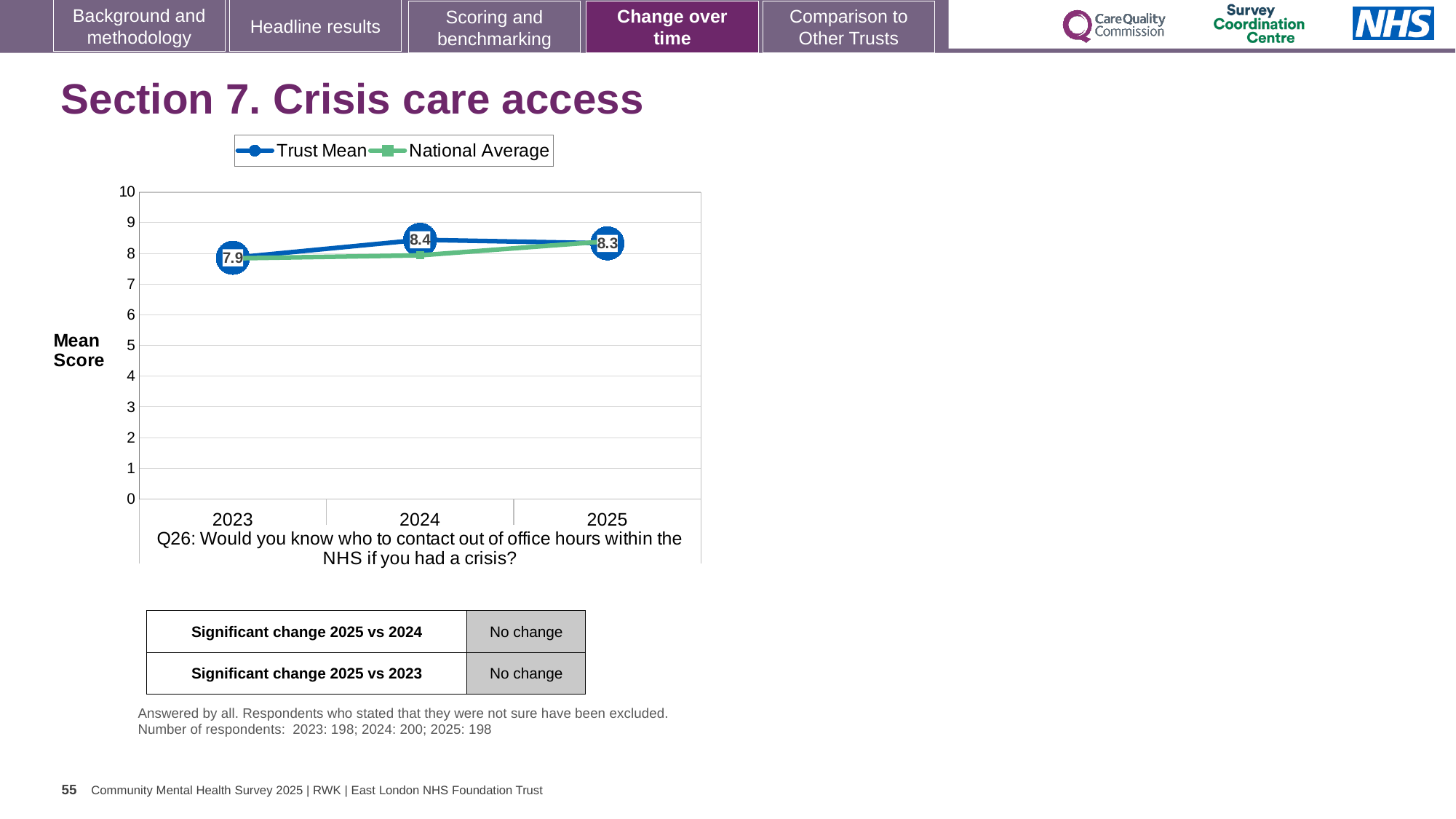
What kind of chart is shown on the slide? Line chart How many years are plotted on the x axis? 3 In which year is the Trust Mean score lowest? 2023 How many series does the legend list? 2 What is the Trust Mean score for 2023? 7.9 In which year is the Trust Mean score highest? 2024 What is the difference between the Trust Mean score in 2024 and in 2023? 0.5 Does the Trust Mean score rise or fall from 2023 to 2024? Rise What is the Trust Mean score for 2024? 8.4 Which year has the larger Trust Mean score, 2024 or 2025? 2024 Is the National Average value for 2025 greater or less than 7? greater What is the Trust Mean score for 2025? 8.3